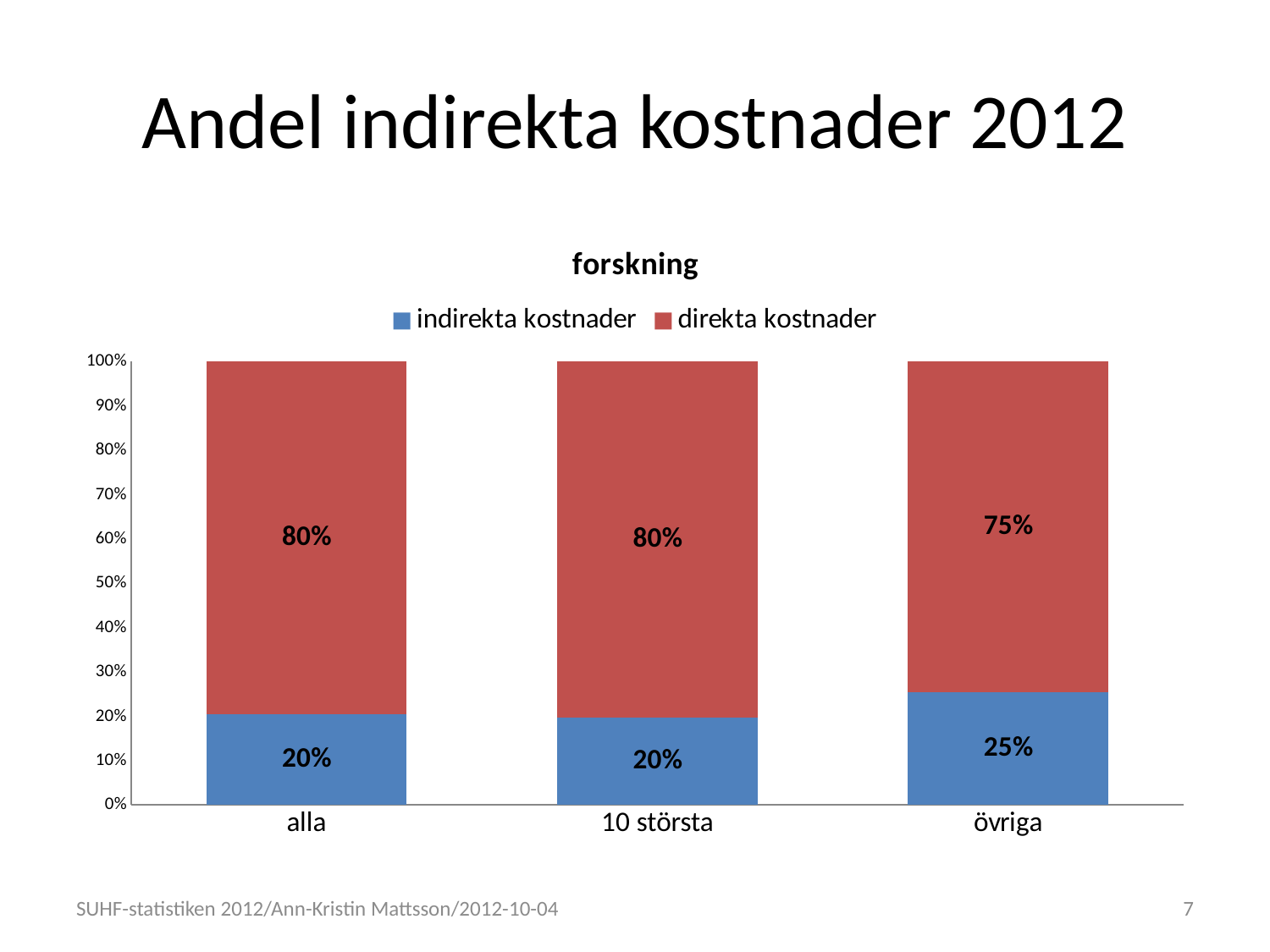
How many series does the legend list? 2 Which is larger: indirekta kostnader for övriga or indirekta kostnader for alla? övriga What is the value of indirekta kostnader for 10 största? 20% How many categories are shown on the x axis? 3 What is the value of indirekta kostnader for övriga? 25% What is the value of direkta kostnader for övriga? 75% What is the difference between direkta kostnader for alla and direkta kostnader for övriga? 5% What is the value of direkta kostnader for alla? 80% Which category has the highest value for indirekta kostnader? övriga What is the title of the chart? forskning Which category has the lowest value for direkta kostnader? övriga What kind of chart is shown on the slide? stacked bar chart